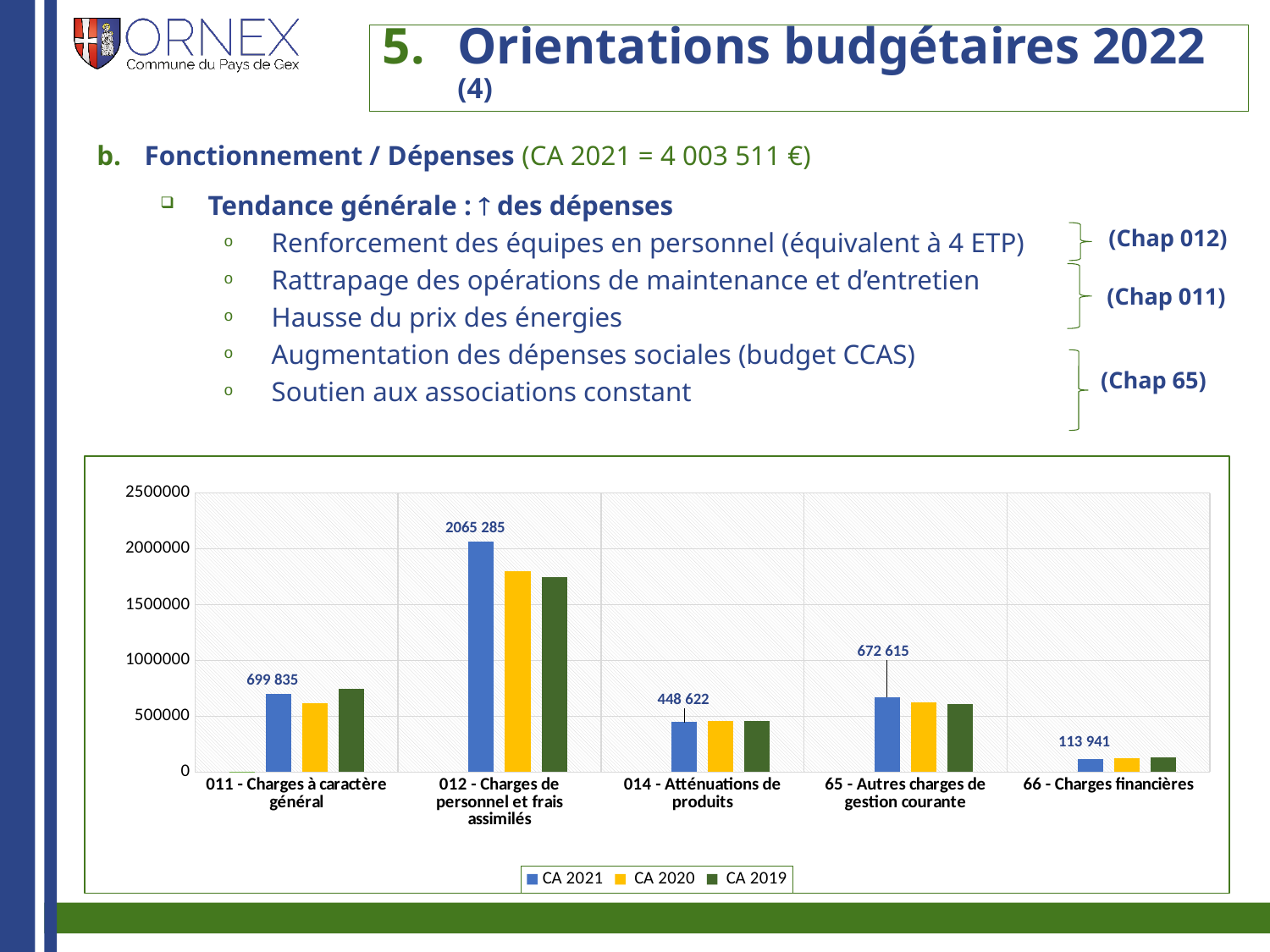
What is the difference between the CA 2021 values for "011 - Charges à caractère général" and "65 - Autres charges de gestion courante"? 27 220 For CA 2021, which is larger: "014 - Atténuations de produits" or "65 - Autres charges de gestion courante"? 65 - Autres charges de gestion courante What is the CA 2021 value for "012 - Charges de personnel et frais assimilés"? 2065 285 Is the CA 2020 value for "012 - Charges de personnel et frais assimilés" greater or less than 1500000? greater Which category has the highest CA 2021 value? 012 - Charges de personnel et frais assimilés How many series does the chart legend list? 3 What is the CA 2021 value for "011 - Charges à caractère général"? 699 835 What type of chart is shown on the slide? bar chart Is the CA 2019 value for "66 - Charges financières" greater or less than 500000? less How many categories are shown on the x axis of the chart? 5 Which category has the lowest CA 2021 value? 66 - Charges financières What is the CA 2021 value for "66 - Charges financières"? 113 941